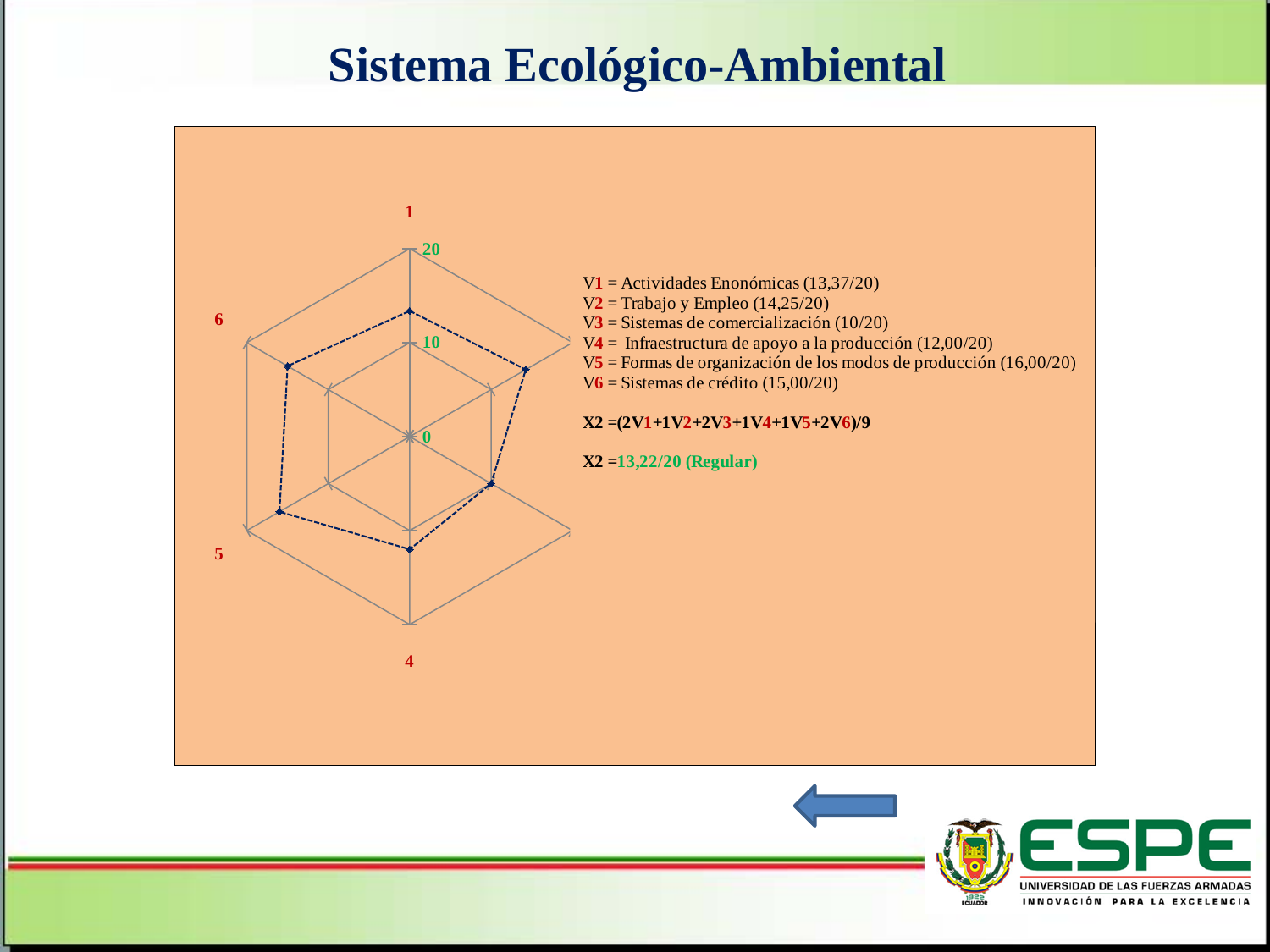
What kind of chart is shown on the slide? Radar chart Which variable has the highest value? V5 How many variables (axes) does the radar chart have? 6 What is the value given for V5 (Formas de organización de los modos de producción)? 16,00/20 Is the value on axis 4 of the radar chart greater or less than 20? less What is the value given for V3 (Sistemas de comercialización)? 10/20 What is the difference between the values of V5 and V4? 4,00 What is the maximum value shown on the radar chart's scale? 20 Which is larger, the value for V6 or the value for V4? V6 What is the value given for V1 (Actividades Enonómicas)? 13,37/20 Which variable has the lowest value? V3 Is the value on axis 1 of the radar chart greater or less than 10? greater